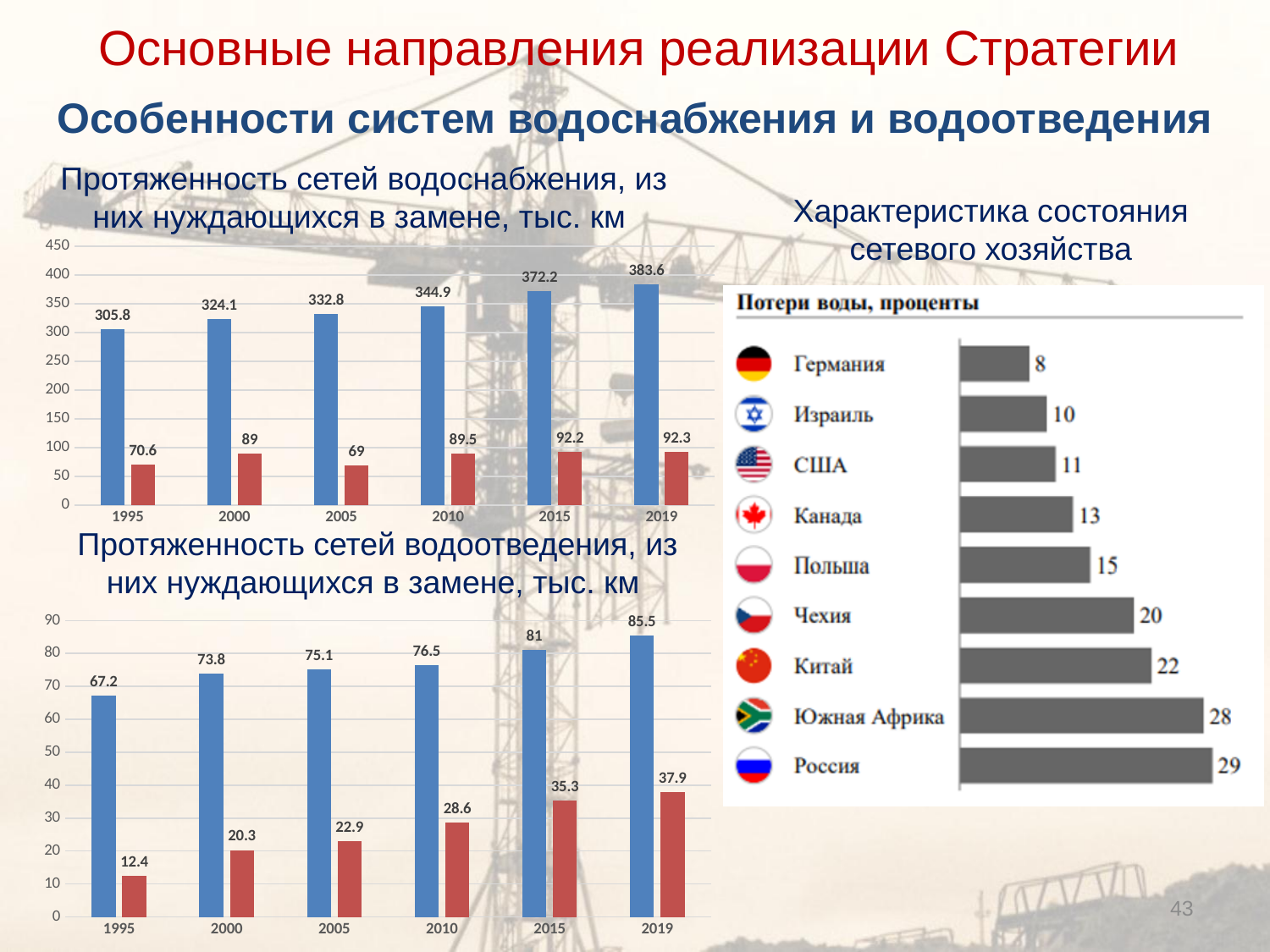
In the chart 'Протяженность сетей водоснабжения, из них нуждающихся в замене, тыс. км', do the blue bars rise or fall from 1995 to 2019? rise In the chart 'Протяженность сетей водоснабжения, из них нуждающихся в замене, тыс. км', what is the value of the red bar for 2005? 69 What kind of chart is 'Потери воды, проценты'? bar chart In the chart 'Протяженность сетей водоотведения, из них нуждающихся в замене, тыс. км', which year has the lowest red bar? 1995 In the chart 'Потери воды, проценты', what is the value for Канада? 13 In the chart 'Протяженность сетей водоотведения, из них нуждающихся в замене, тыс. км', how many years are shown on the x axis? 6 In the chart 'Потери воды, проценты', how many countries are listed? 9 In the chart 'Протяженность сетей водоотведения, из них нуждающихся в замене, тыс. км', what is the difference between the red bars for 2019 and 2015? 2.6 In the chart 'Протяженность сетей водоснабжения, из них нуждающихся в замене, тыс. км', what is the value of the blue bar for 2019? 383.6 In the chart 'Протяженность сетей водоснабжения, из них нуждающихся в замене, тыс. км', what is the difference between the blue bar and the red bar for 1995? 235.2 In the chart 'Протяженность сетей водоотведения, из них нуждающихся в замене, тыс. км', what is the value of the red bar for 2010? 28.6 In the chart 'Потери воды, проценты', which country has the highest value? Россия